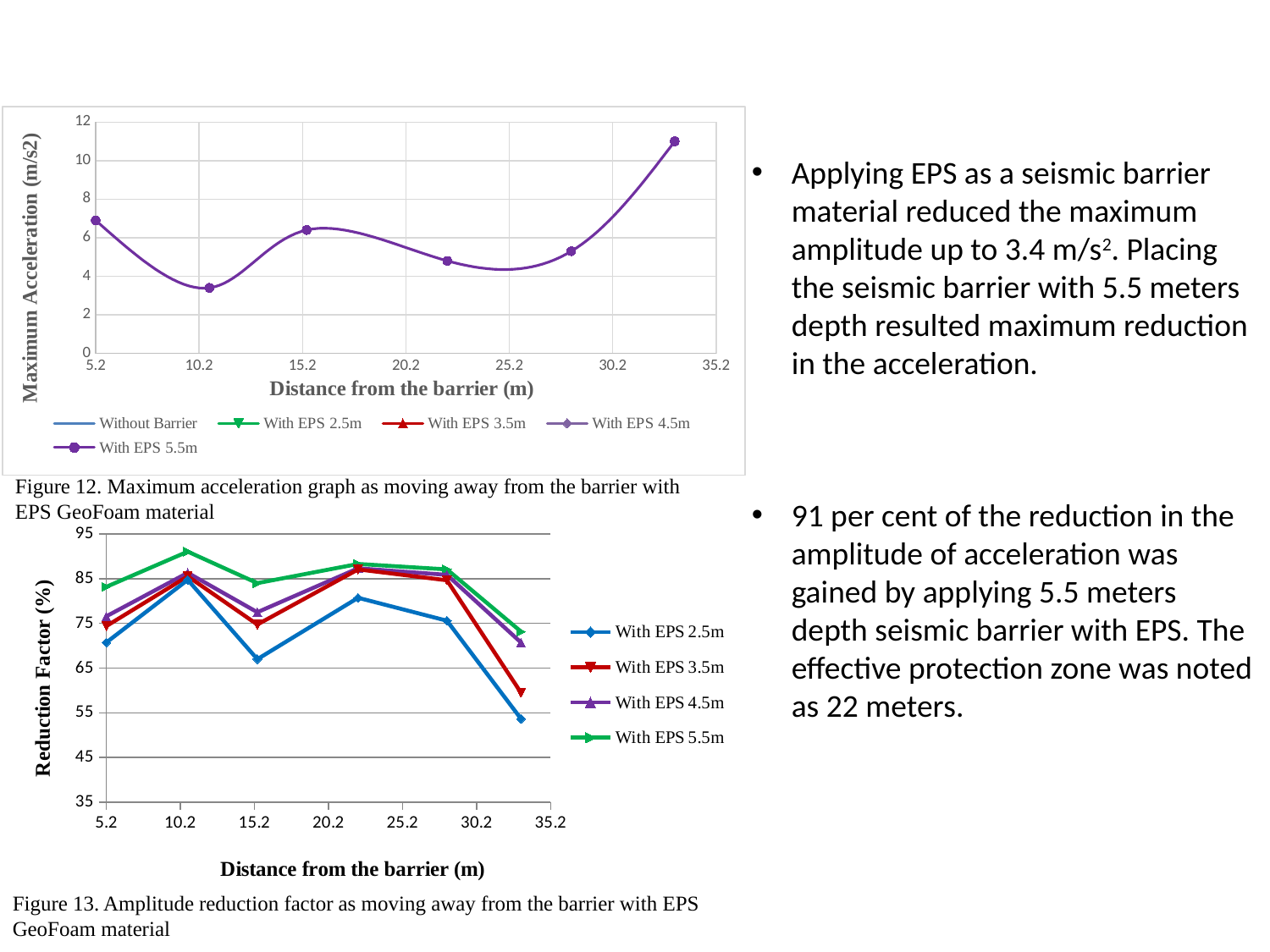
How many series does the legend of Figure 13 (the bottom chart) list? 4 How many series does the legend of Figure 12 (the top chart) list? 5 In Figure 12 (the top chart), is the value of the With EPS 5.5m line at 5.2 m greater or less than 6? greater In Figure 13 (the bottom chart), which series has the lowest reduction factor at 15.2 m? With EPS 2.5m What type of chart is Figure 12 (the top chart)? line chart What is the y-axis title of Figure 13 (the bottom chart)? Reduction Factor (%) In Figure 13 (the bottom chart), do the reduction factor lines rise or fall between 30.2 m and 35.2 m? fall In Figure 12 (the top chart), is the lowest point of the With EPS 5.5m line greater or less than 4? less In Figure 12 (the top chart), which plotted point of the With EPS 5.5m line has the highest maximum acceleration, the first or the last? the last In Figure 12 (the top chart), is the last plotted point of the With EPS 5.5m line greater or less than 10? greater In Figure 13 (the bottom chart), which series has the highest reduction factor at 10.2 m? With EPS 5.5m